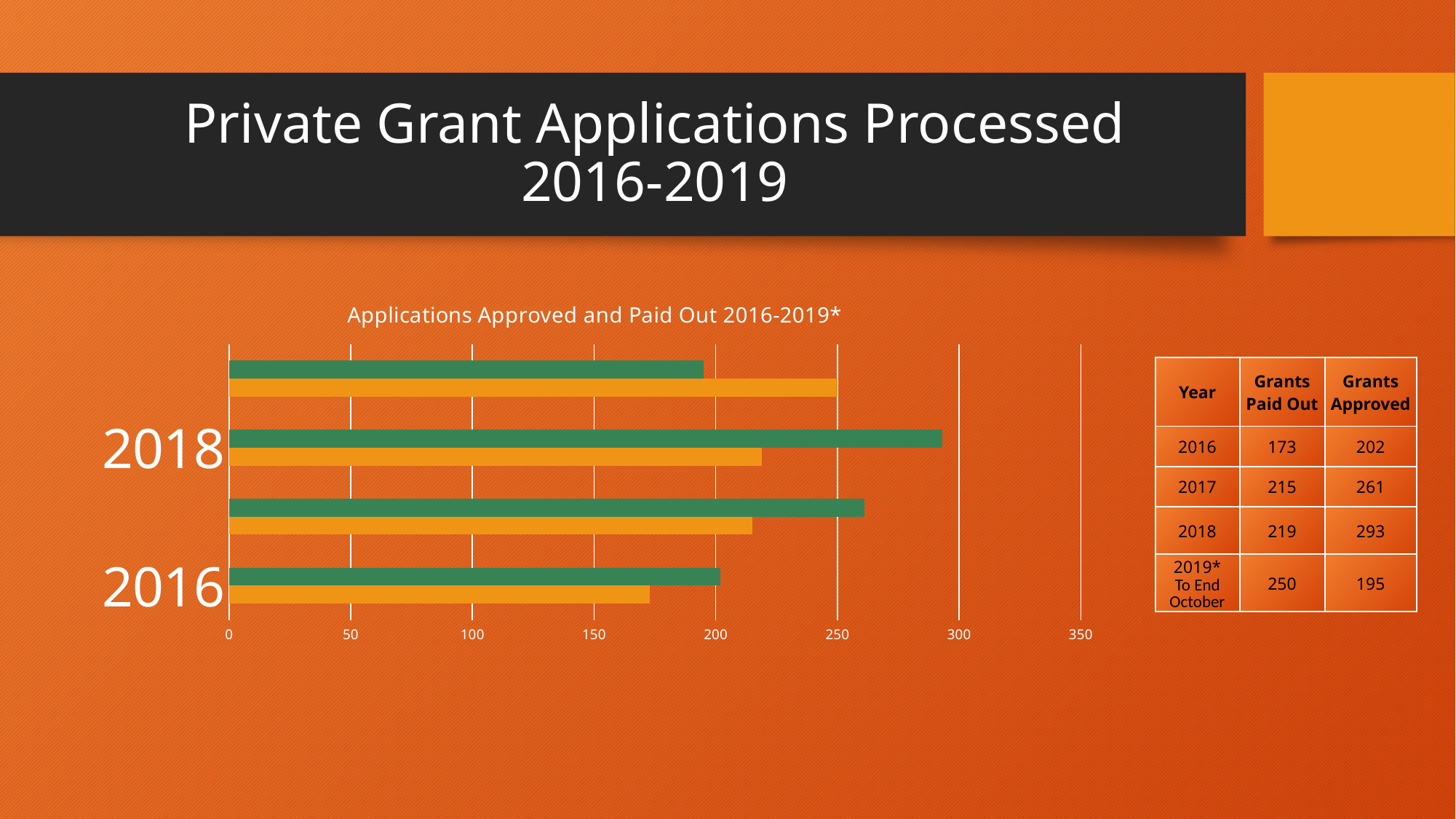
Is the value of the orange bar for 2016 greater or less than 200? less What kind of chart is shown on the slide? bar chart Is the value of the longest green bar (2018) greater or less than 250? greater What is the difference between grants approved and grants paid out in 2018? 74 According to the slide, how many grants were paid out in 2017? 215 According to the slide, how many grants were approved in 2018? 293 What is the title of the chart? Applications Approved and Paid Out 2016-2019* For 2019, which is larger: grants paid out or grants approved? grants paid out Which year has the longest green bar in the chart? 2018 How many years (categories) are plotted in the chart? 4 Do the grants approved values rise or fall from 2016 to 2018? rise What is the highest value shown on the chart's horizontal axis? 350